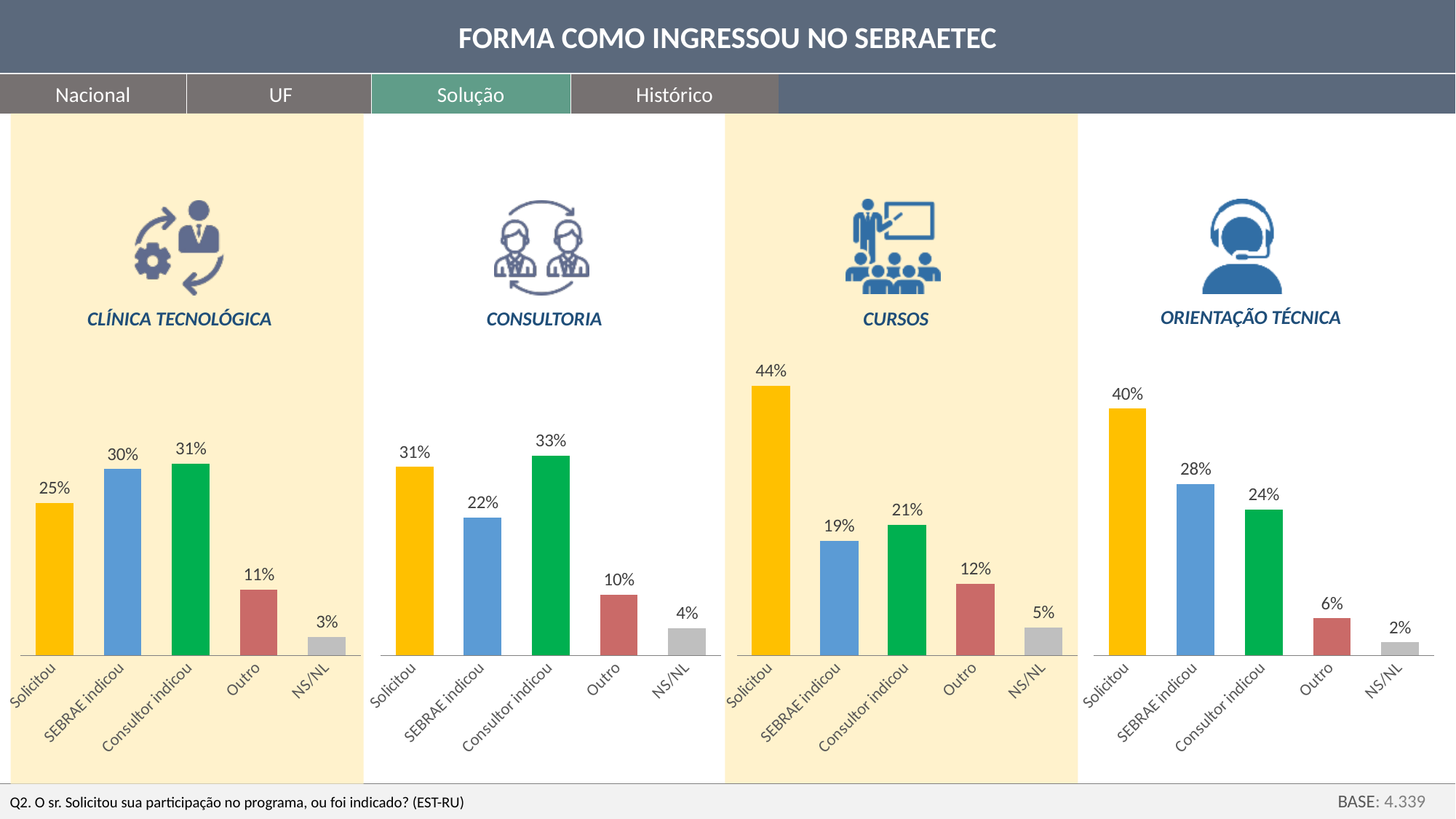
How many categories does the CONSULTORIA chart show? 5 How many charts are shown on the slide? 4 In the CURSOS chart, which category has the highest value? Solicitou In the CLÍNICA TECNOLÓGICA chart, what is the value for Solicitou? 25% In the CLÍNICA TECNOLÓGICA chart, what is the difference between Consultor indicou and NS/NL? 28% In the CURSOS chart, what is the difference between Solicitou and SEBRAE indicou? 25% In the CONSULTORIA chart, what is the value for Consultor indicou? 33% In the ORIENTAÇÃO TÉCNICA chart, which is larger: SEBRAE indicou or Consultor indicou? SEBRAE indicou In the CONSULTORIA chart, what is the value for Outro? 10% What kind of chart is the CLÍNICA TECNOLÓGICA chart? Bar chart In the ORIENTAÇÃO TÉCNICA chart, what is the value for Solicitou? 40% In the ORIENTAÇÃO TÉCNICA chart, which category has the lowest value? NS/NL